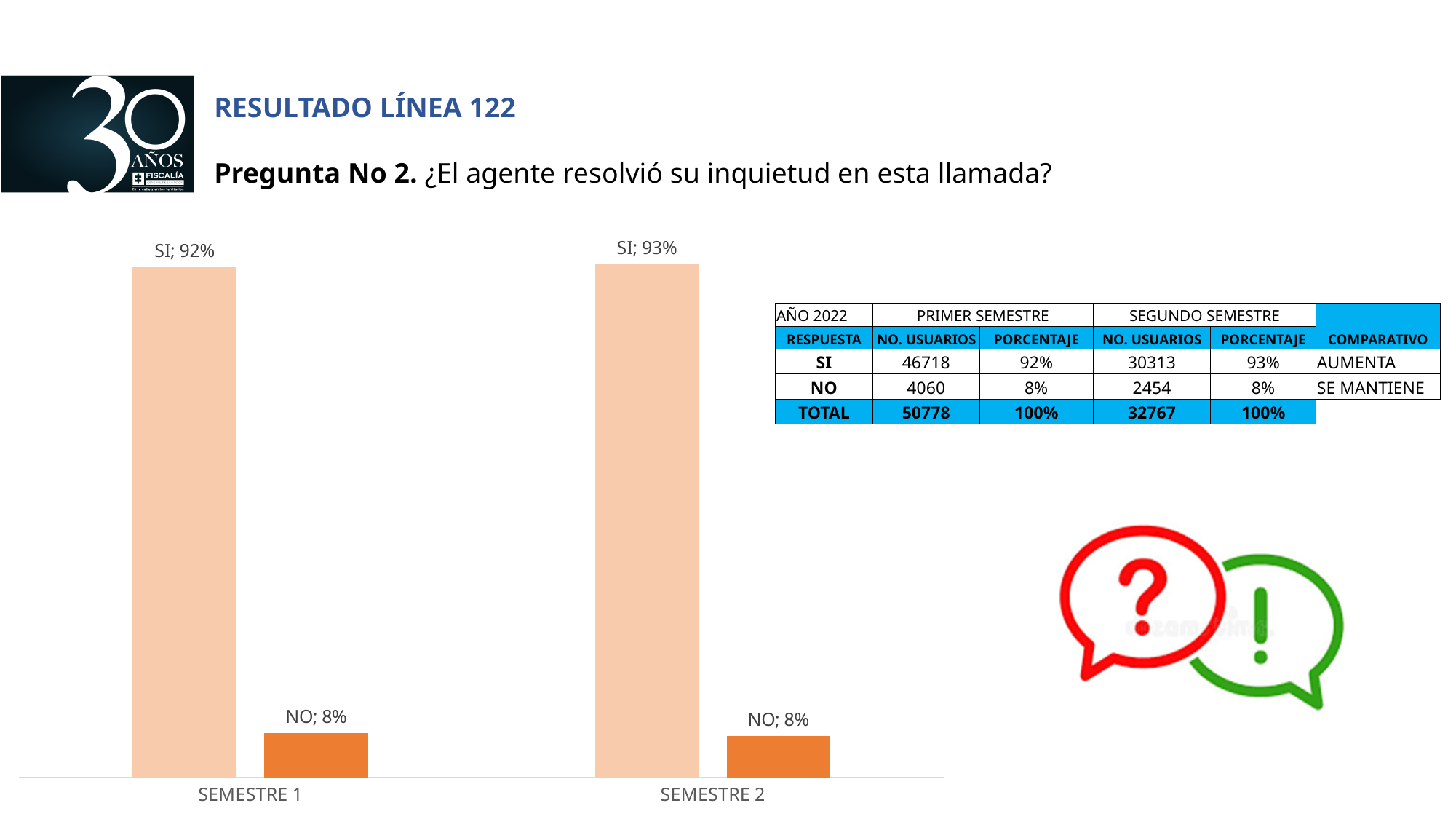
What is the difference between the SI and NO values in SEMESTRE 1? 84% What is the value for NO in SEMESTRE 1? 8% What is the total of the SI and NO values in SEMESTRE 1? 100% Does the SI value rise or fall from SEMESTRE 1 to SEMESTRE 2? rise What is the value for NO in SEMESTRE 2? 8% How many categories are shown on the x axis of the chart? 2 What is the difference between the SI value in SEMESTRE 2 and the SI value in SEMESTRE 1? 1% Which is larger in SEMESTRE 2, the SI value or the NO value? SI Which bar has the highest value in the chart? SI in SEMESTRE 2 What is the value for SI in SEMESTRE 1? 92% What is the value for SI in SEMESTRE 2? 93% What kind of chart is shown on the slide? bar chart